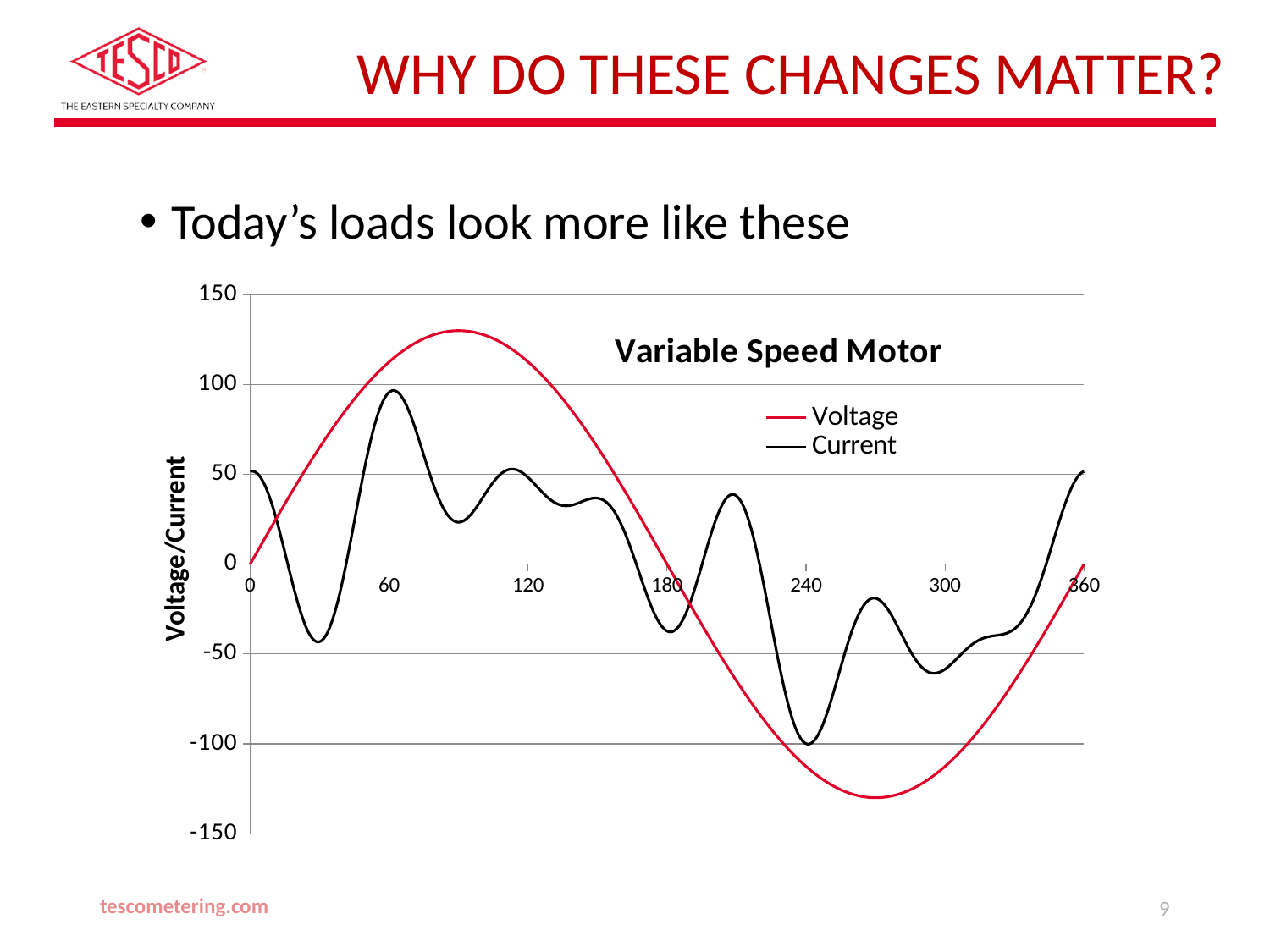
What kind of chart is shown on the slide? Line chart Is the value of the Voltage series at x = 90 greater or less than 100? greater Does the Voltage series rise or fall between x = 90 and x = 270? Fall Is the value of the Current series at x = 60 greater or less than 50? greater What is the value of the Voltage series at x = 0? 0 What is the label on the vertical axis of the chart? Voltage/Current What is the title of the chart? Variable Speed Motor Is the value of the Current series at x = 30 greater or less than 0? less What is the value of the Voltage series at x = 180? 0 At x = 90, which series has the higher value, Voltage or Current? Voltage How many series does the chart's legend list? 2